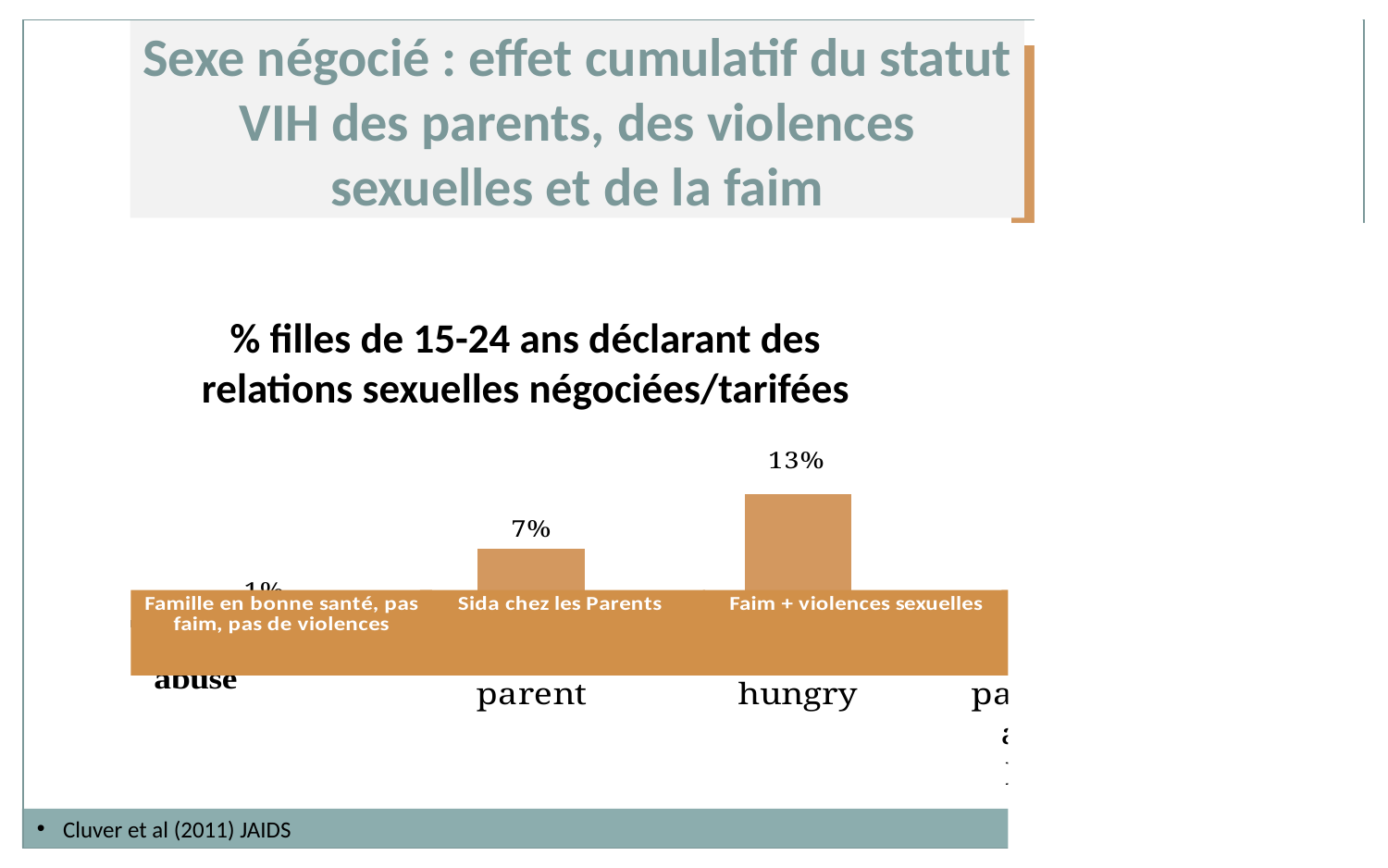
What colour are the bars in the chart? Orange What is the value for 'Sida chez les Parents'? 7% What kind of chart is shown on the slide? Bar chart What is the difference between the values for 'Faim + violences sexuelles' and 'Sida chez les Parents'? 6% Which is larger, the value for 'Sida chez les Parents' or the value for 'Faim + violences sexuelles'? Faim + violences sexuelles Which is larger, the value for 'Famille en bonne santé, pas faim, pas de violences' or the value for 'Sida chez les Parents'? Sida chez les Parents What is the difference between the values for 'Sida chez les Parents' and 'Famille en bonne santé, pas faim, pas de violences'? 6% Do the values rise or fall from 'Famille en bonne santé, pas faim, pas de violences' to 'Faim + violences sexuelles'? Rise What is the value for 'Faim + violences sexuelles'? 13% What is the value for 'Famille en bonne santé, pas faim, pas de violences'? 1% What is the title of the chart? % filles de 15-24 ans déclarant des relations sexuelles négociées/tarifées